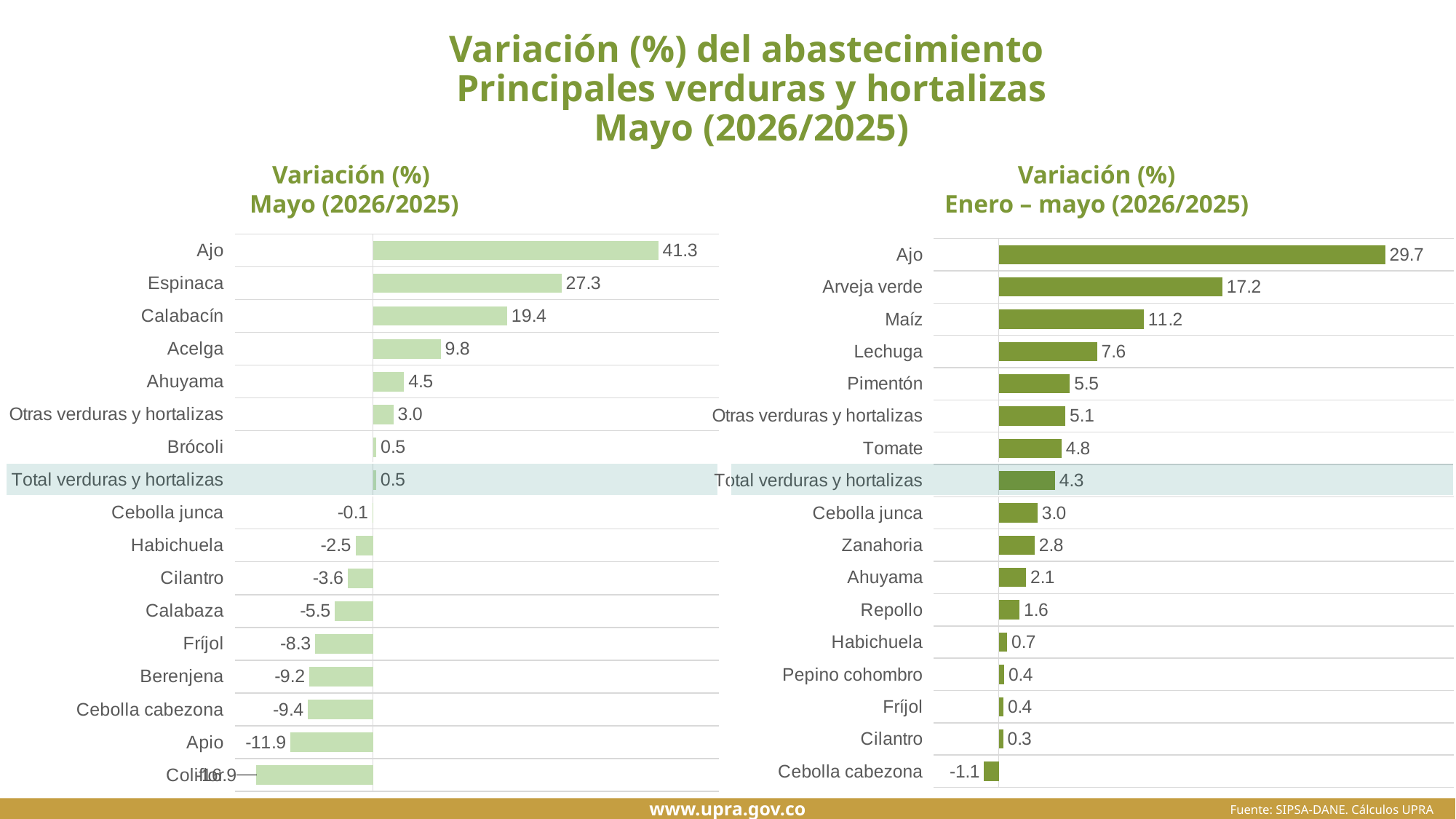
In the chart titled 'Variación (%) Enero – mayo (2026/2025)', what is the difference between the values for Ajo and Maíz? 18.5 In the chart titled 'Variación (%) Mayo (2026/2025)', what is the value for Espinaca? 27.3 In the chart titled 'Variación (%) Enero – mayo (2026/2025)', which category has the lowest value? Cebolla cabezona What kind of chart is the chart titled 'Variación (%) Mayo (2026/2025)'? Bar chart In the chart titled 'Variación (%) Enero – mayo (2026/2025)', what is the value for Arveja verde? 17.2 In the chart titled 'Variación (%) Enero – mayo (2026/2025)', which is larger, the value for Lechuga or the value for Pimentón? Lechuga In the chart titled 'Variación (%) Enero – mayo (2026/2025)', what is the value for Total verduras y hortalizas? 4.3 In the chart titled 'Variación (%) Mayo (2026/2025)', what is the difference between the values for Ajo and Calabacín? 21.9 In the chart titled 'Variación (%) Enero – mayo (2026/2025)', how many categories are shown? 17 In the chart titled 'Variación (%) Mayo (2026/2025)', what is the value for Apio? -11.9 In the chart titled 'Variación (%) Mayo (2026/2025)', which category has the highest value? Ajo In the chart titled 'Variación (%) Mayo (2026/2025)', which is larger, the value for Berenjena or the value for Cebolla cabezona? Berenjena